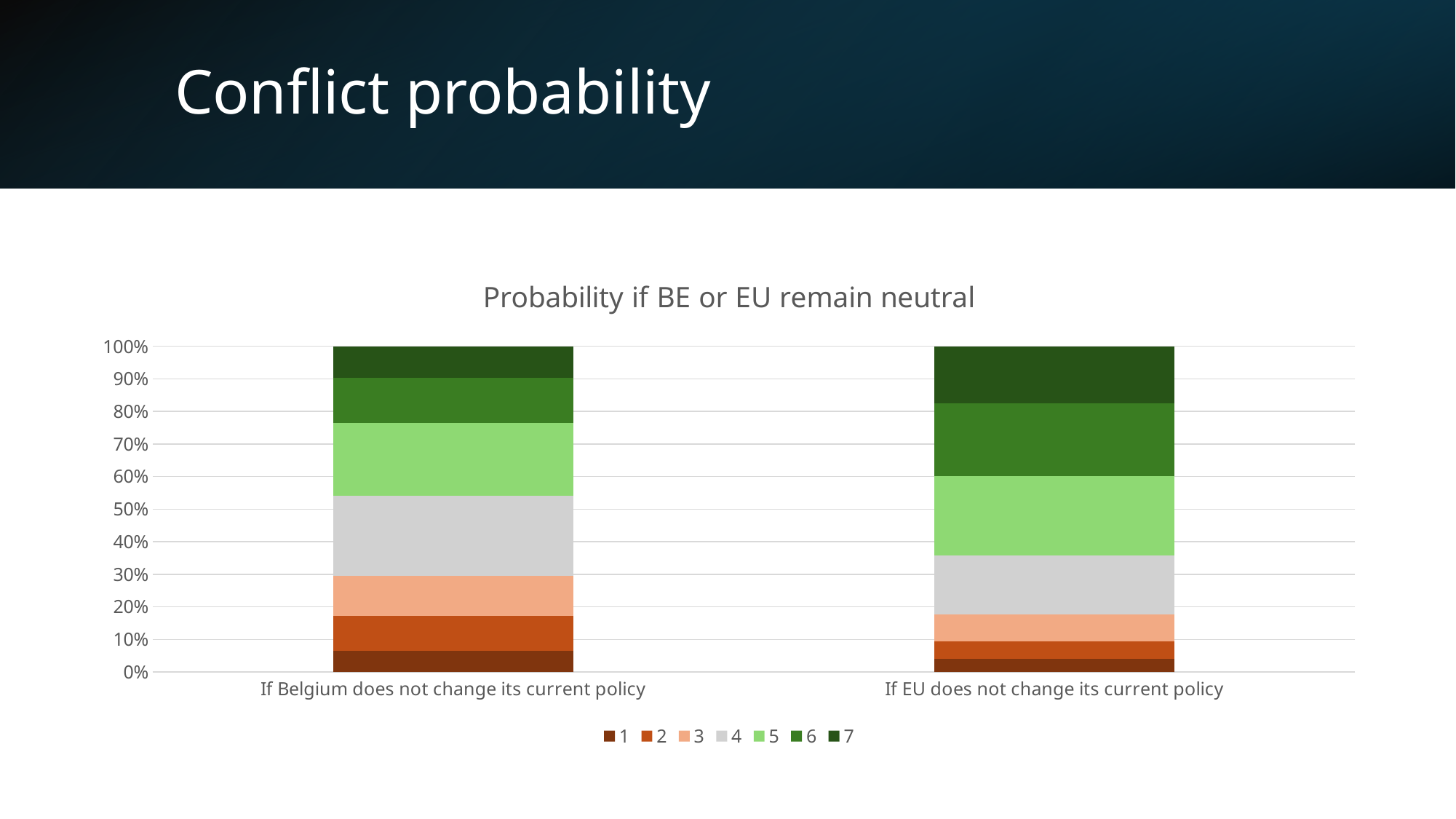
What is the total height of the stacked bar for 'If Belgium does not change its current policy'? 100% Is the segment for series 7 in the 'If EU does not change its current policy' bar greater or less than 10%? greater What is the title of the chart? Probability if BE or EU remain neutral Which category has the larger segment for series 6: 'If Belgium does not change its current policy' or 'If EU does not change its current policy'? If EU does not change its current policy Is the segment for series 1 in the 'If Belgium does not change its current policy' bar greater or less than 10%? less Which category has the larger segment for series 4: 'If Belgium does not change its current policy' or 'If EU does not change its current policy'? If Belgium does not change its current policy Is the segment for series 4 in the 'If Belgium does not change its current policy' bar greater or less than 20%? greater How many categories are shown on the x axis of the chart? 2 Which category has the larger segment for series 7: 'If Belgium does not change its current policy' or 'If EU does not change its current policy'? If EU does not change its current policy How many series does the legend list? 7 What kind of chart is shown on the slide? Stacked bar chart Which series in the 'If Belgium does not change its current policy' bar has the largest segment? 4